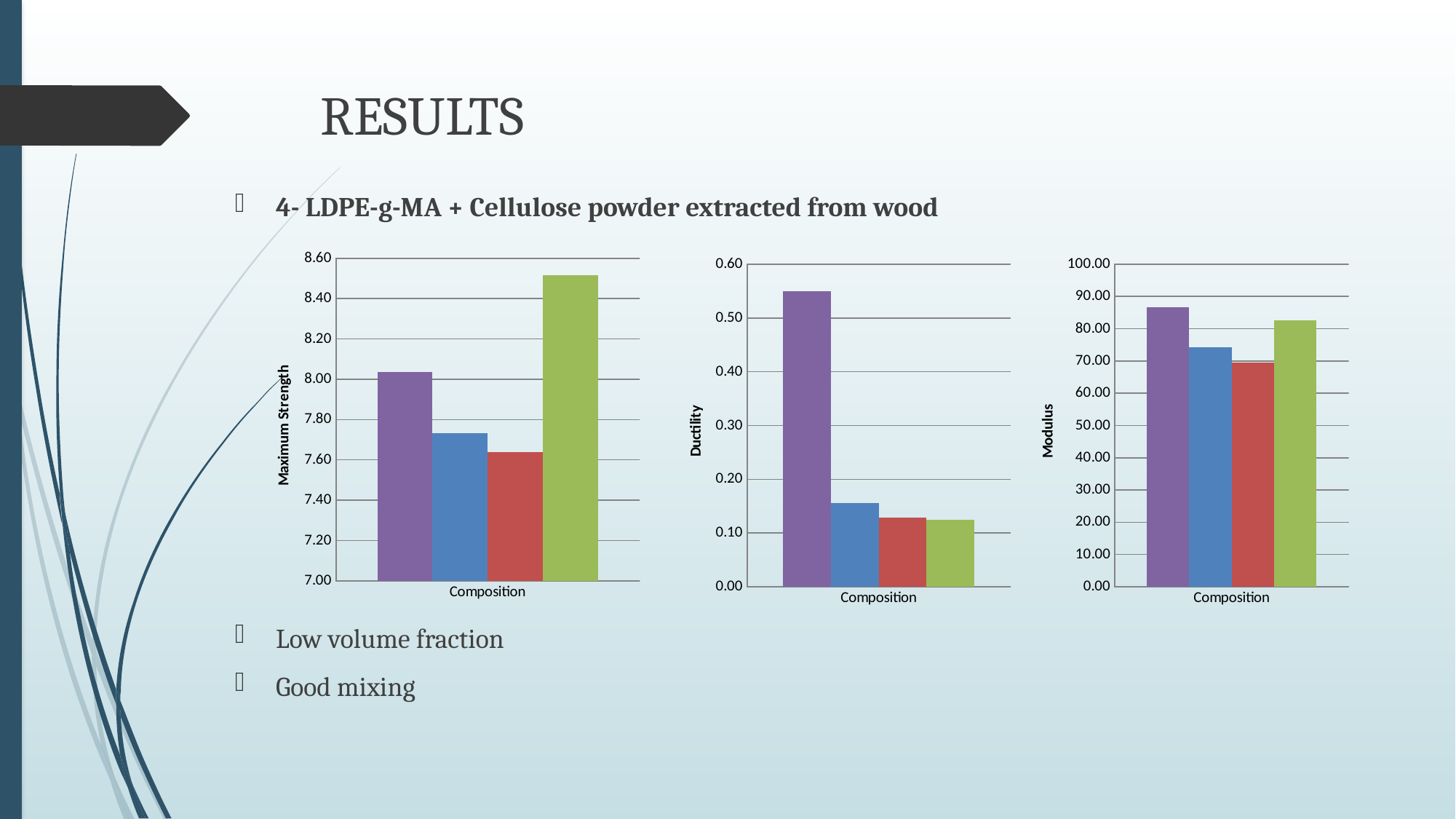
In the Ductility chart in the middle, do the bar values rise or fall from left to right? fall How many bars are plotted in the Ductility chart in the middle? 4 In the Maximum Strength chart on the left, is the value of the green bar greater or less than 8.40? greater In the Ductility chart in the middle, which coloured bar is the highest? purple In the Maximum Strength chart on the left, is the value of the blue bar greater or less than 7.80? less In the Ductility chart in the middle, is the value of the purple bar greater or less than 0.50? greater What is the y-axis label of the chart on the right? Modulus In the Modulus chart on the right, is the purple bar or the green bar larger? purple In the Modulus chart on the right, which coloured bar is the lowest? red In the Maximum Strength chart on the left, which coloured bar is the highest? green In the Maximum Strength chart on the left, which coloured bar is the lowest? red What kind of chart is the Maximum Strength chart on the left? bar chart